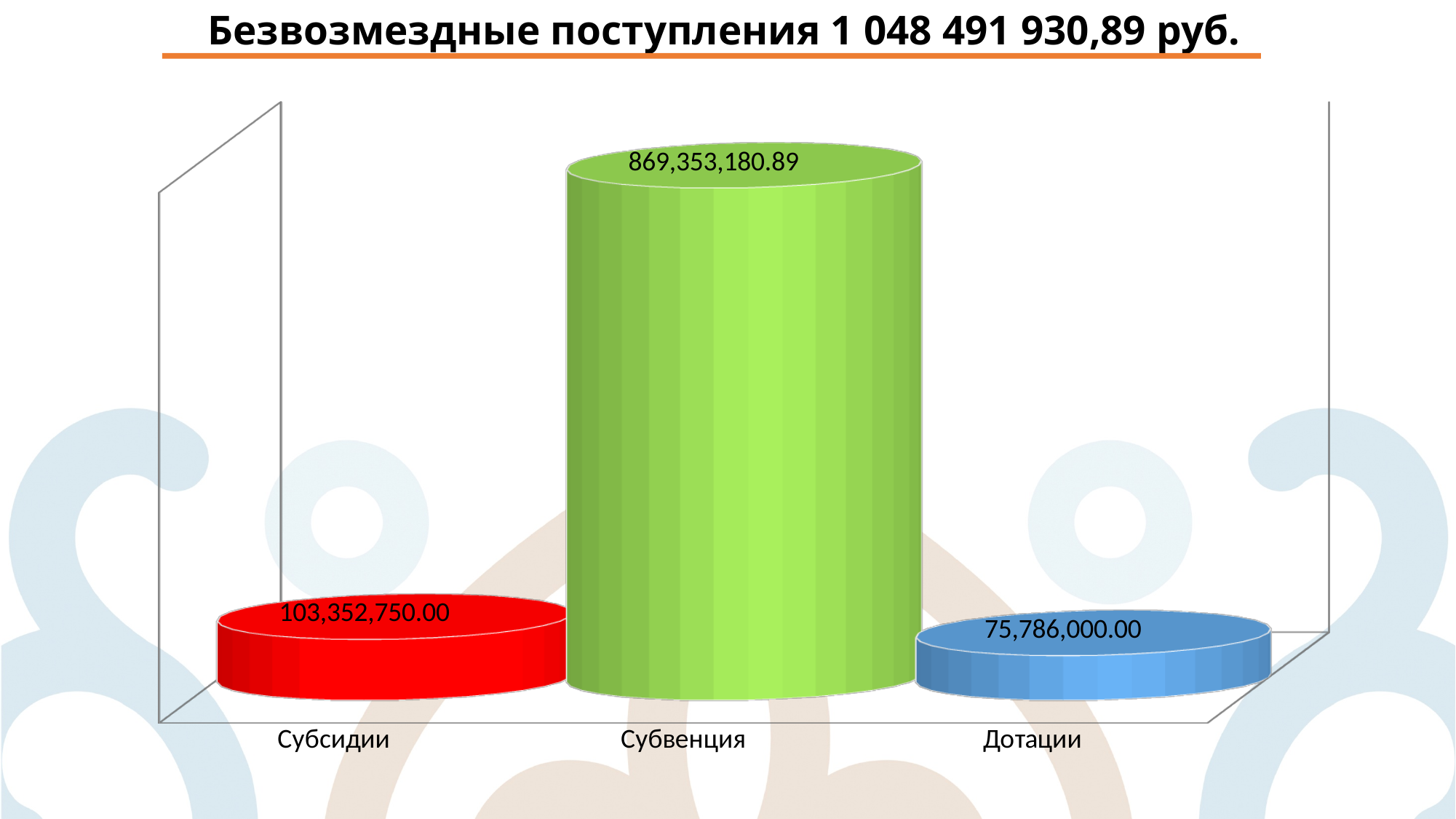
What colour is the bar for Субвенция? Green What is the difference between the values for Субсидии and Дотации? 27,566,750.00 What is the difference between the values for Субвенция and Субсидии? 766,000,430.89 What is the value shown for Дотации? 75,786,000.00 What is the value shown for Субвенция? 869,353,180.89 Which is larger, the value for Субсидии or the value for Дотации? Субсидии How many categories are shown in the chart? 3 What is the title of the slide? Безвозмездные поступления 1 048 491 930,89 руб. What is the value shown for Субсидии? 103,352,750.00 Which category has the highest value? Субвенция Which category has the lowest value? Дотации What kind of chart is shown on the slide? Bar chart